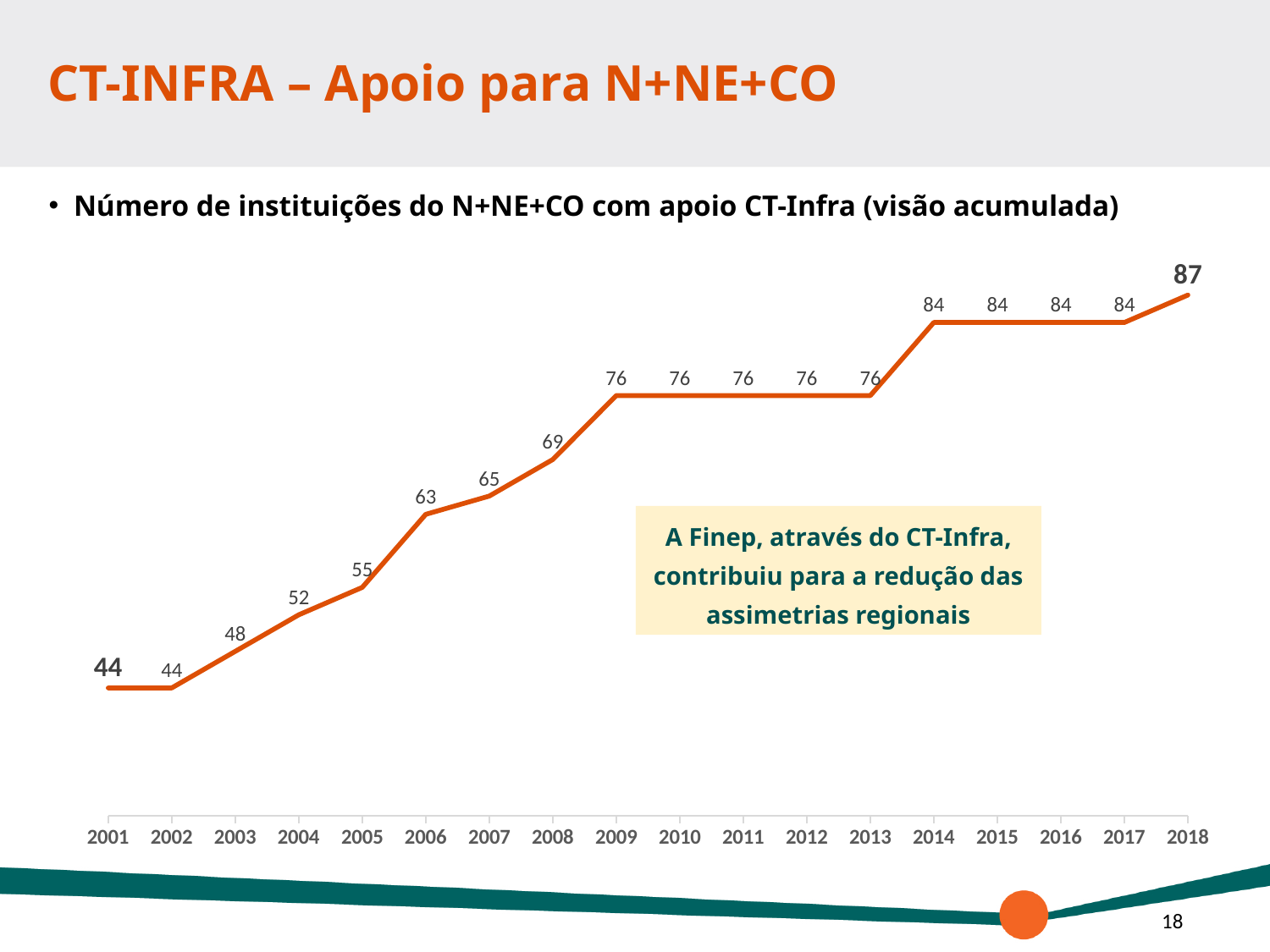
How many years are plotted on the x axis? 18 Which year has the highest value? 2018 What is the difference between the values for 2014 and 2013? 8 What type of chart is shown on the slide? line chart What is the value for 2011? 76 What is the value for 2006? 63 Which is larger, the value for 2008 or the value for 2005? 2008 What is the difference between the values for 2018 and 2001? 43 Do the values generally rise or fall from 2001 to 2018? rise What is the lowest value shown on the chart? 44 What is the value for 2001? 44 What is the value for 2018? 87